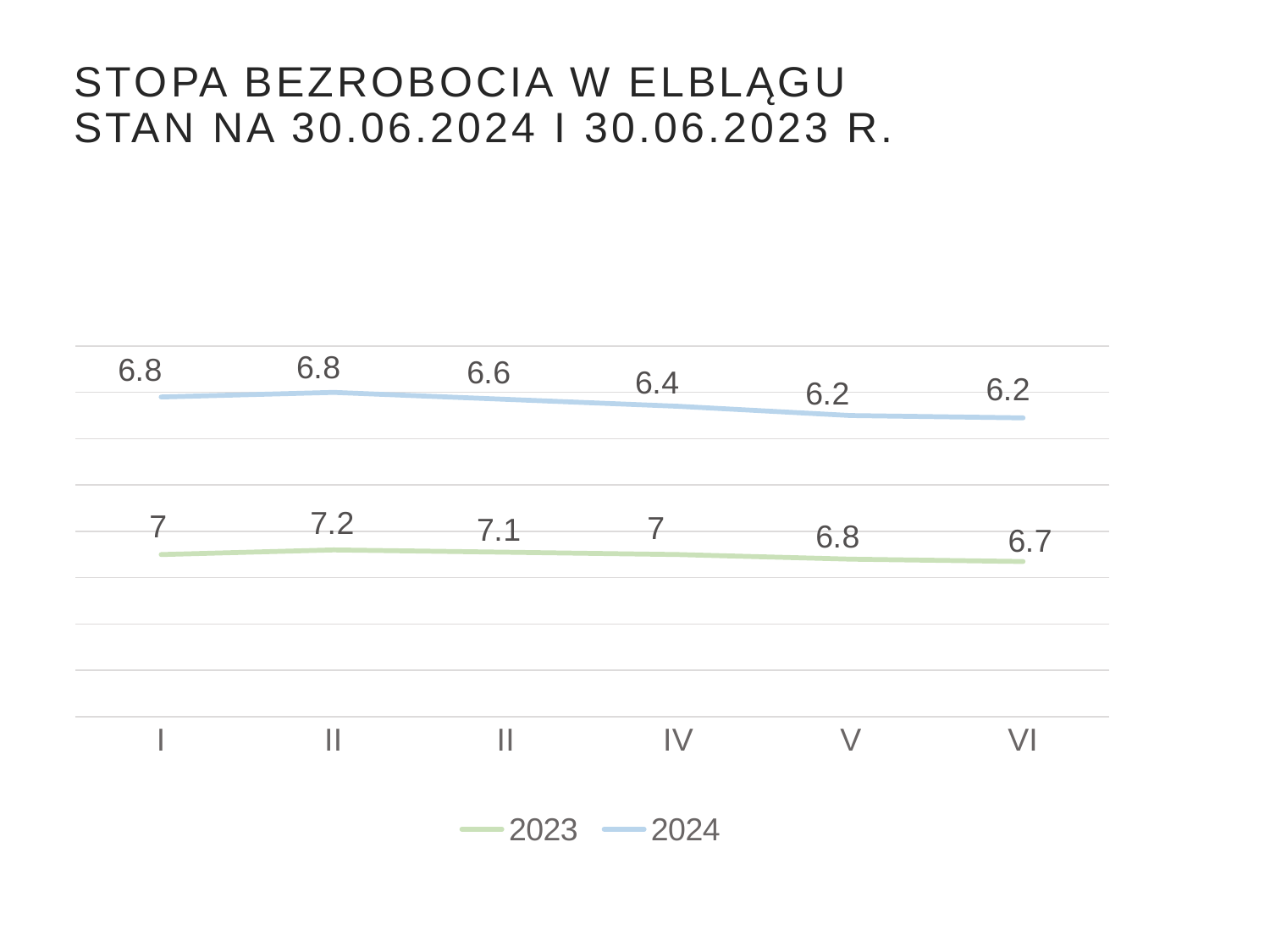
What is the difference between the 2023 and 2024 values at category VI? 0.5 How many points are plotted along the x axis for each series? 6 What is the lowest value in the 2024 series? 6.2 What is the value for the 2023 series at category VI? 6.7 What type of chart is shown on the slide? line chart What is the value for the 2024 series at category I? 6.8 Which series has the larger value at category I, 2023 or 2024? 2023 What is the highest value in the 2023 series? 7.2 What is the value for the 2023 series at category V? 6.8 Do the values of the 2024 series rise or fall from category I to category VI? fall What is the value for the 2024 series at category IV? 6.4 How many series does the legend list? 2